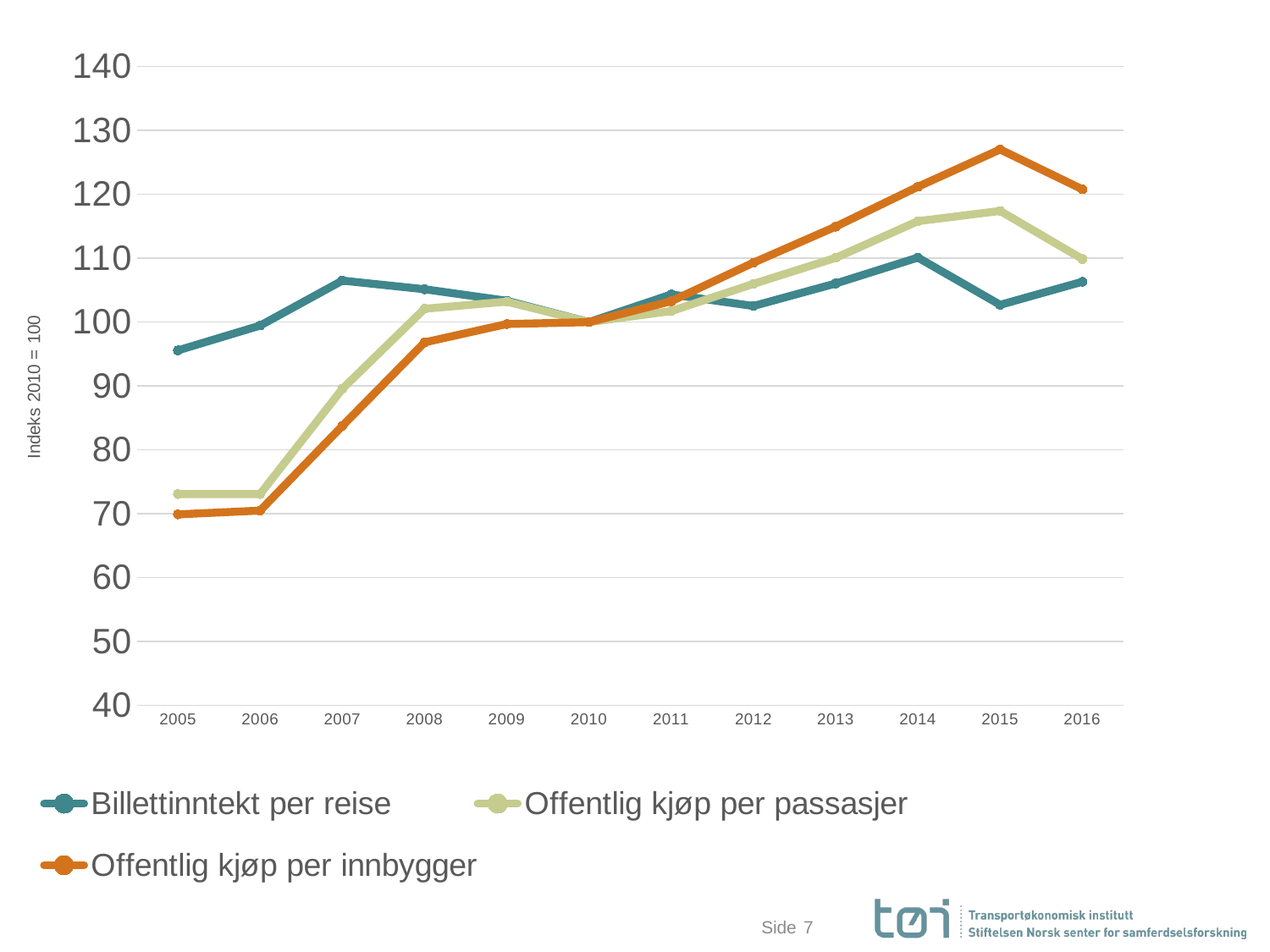
Is the value for Billettinntekt per reise in 2005 greater or less than 100? less What kind of chart is shown on the slide? line chart Is the value for Offentlig kjøp per innbygger in 2015 greater or less than 120? greater What is the label on the vertical axis? Indeks 2010 = 100 Does Offentlig kjøp per innbygger rise or fall between 2006 and 2008? rise In which year does Offentlig kjøp per innbygger reach its highest value? 2015 Is the value for Offentlig kjøp per passasjer in 2006 greater or less than 80? less How many series does the legend list? 3 In which year is Offentlig kjøp per passasjer at its lowest? 2005 and 2006 (tied) What is the value of Offentlig kjøp per innbygger in 2010? 100 In 2016, which series has the higher value: Billettinntekt per reise or Offentlig kjøp per innbygger? Offentlig kjøp per innbygger How many years are shown along the x axis? 12